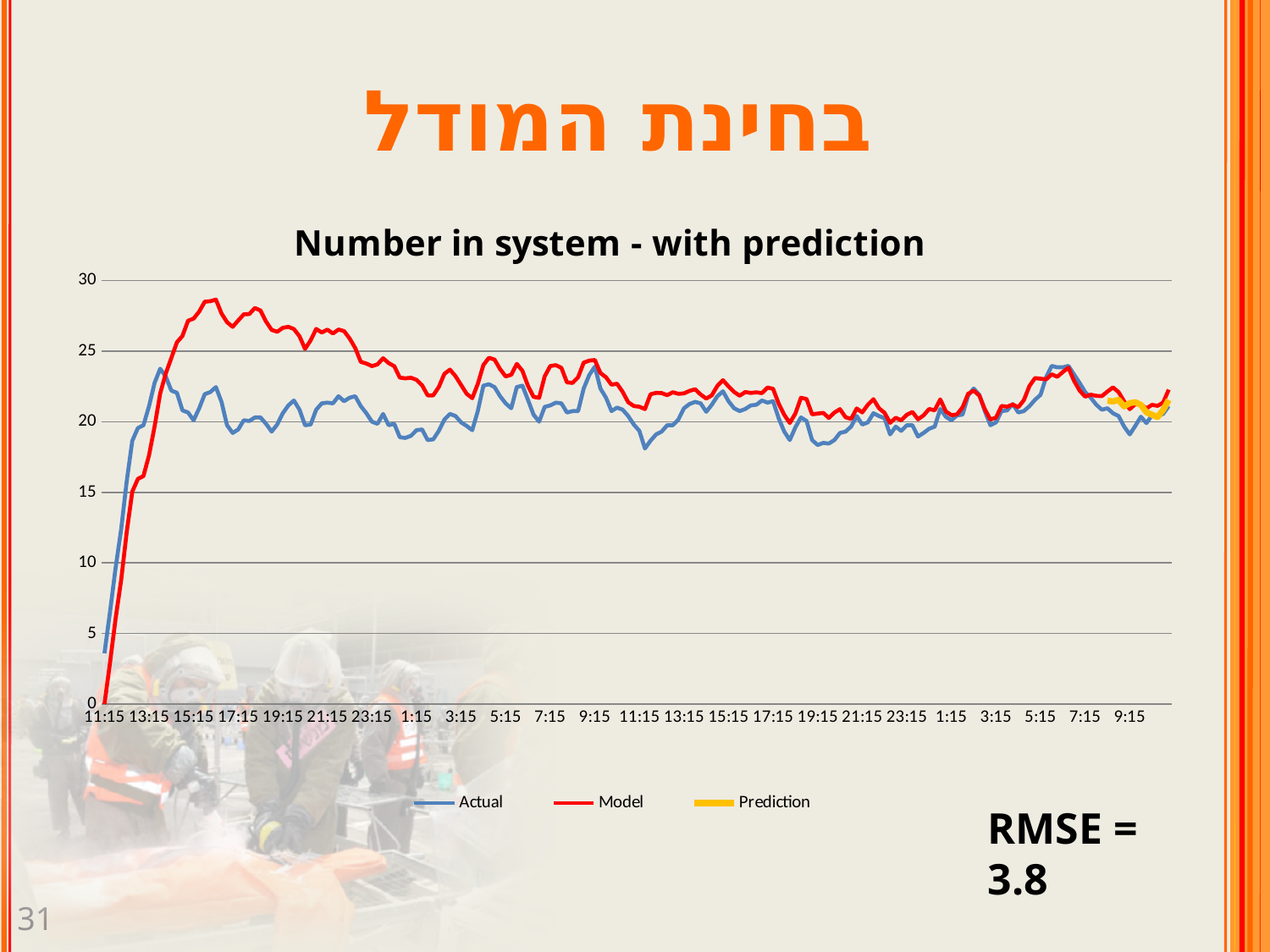
How many series does the legend list? 3 Is the value of the Model line at the first 15:15 greater or less than 25? greater Is the value of the Actual line at the first 17:15 greater or less than 25? less What is the title of the chart? Number in system - with prediction Is the value of the Model line at the first 17:15 greater or less than 25? greater How many time labels are shown on the x axis? 24 What colour is the Prediction line in the legend? orange At the first 23:15, which line is higher, Actual or Model? Model What kind of chart is shown on the slide? line chart Does the Actual line rise or fall between the first 11:15 and the first 13:15? rise Does the Model line rise or fall between the first 17:15 and the first 1:15? fall